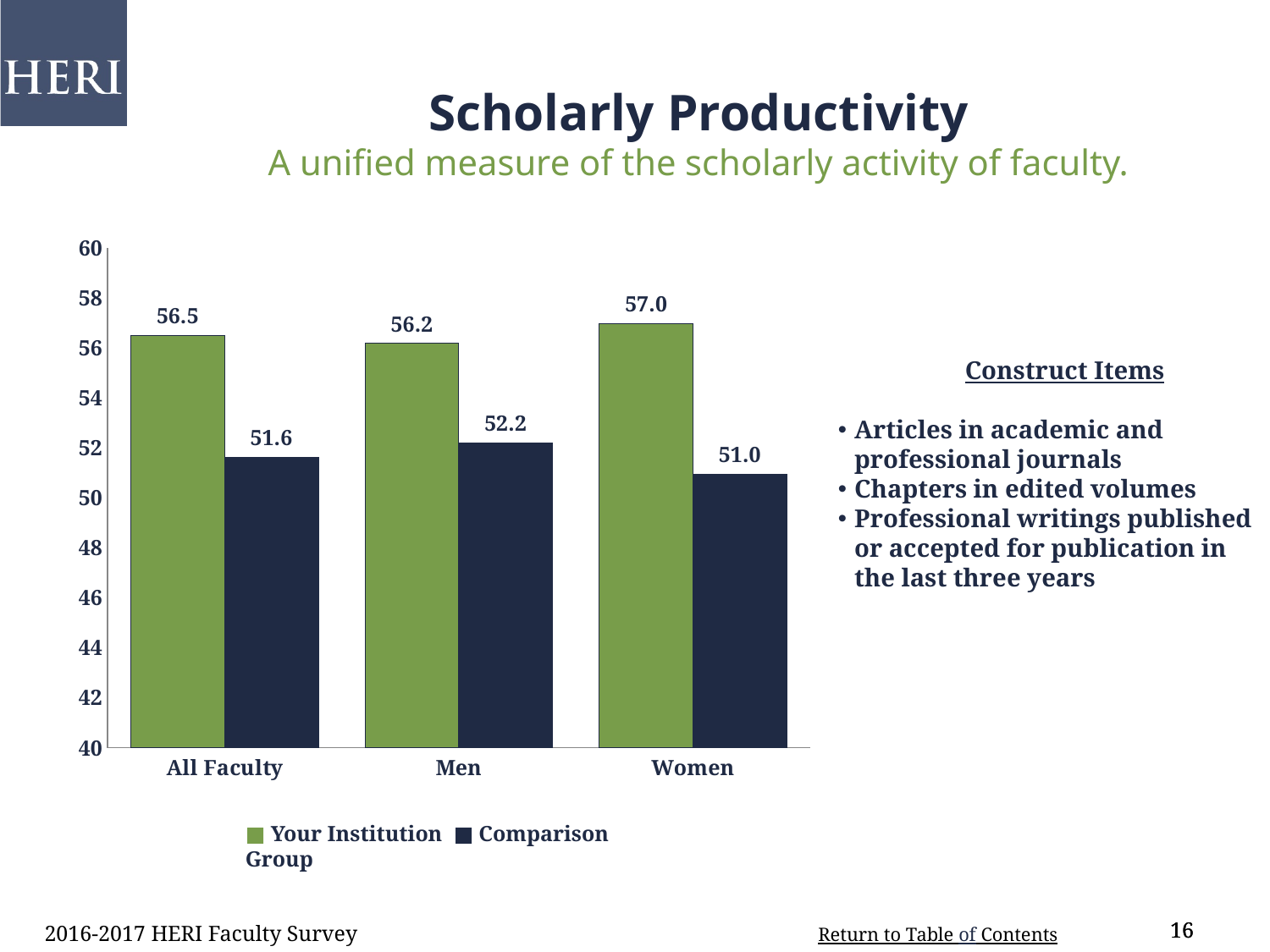
How many series does the legend list? 2 Which category has the highest Your Institution value? Women How many categories are shown on the x axis? 3 What is the Comparison Group value for All Faculty? 51.6 What is the Comparison Group value for Men? 52.2 What is the difference between the Your Institution and Comparison Group values for Women? 6.0 What is the Your Institution value for Women? 57.0 Which is larger for Men: the Your Institution value or the Comparison Group value? Your Institution What kind of chart is shown on the slide? Bar chart What colour are the Comparison Group bars? Dark navy blue Which category has the lowest Comparison Group value? Women What is the difference between the Your Institution and Comparison Group values for All Faculty? 4.9